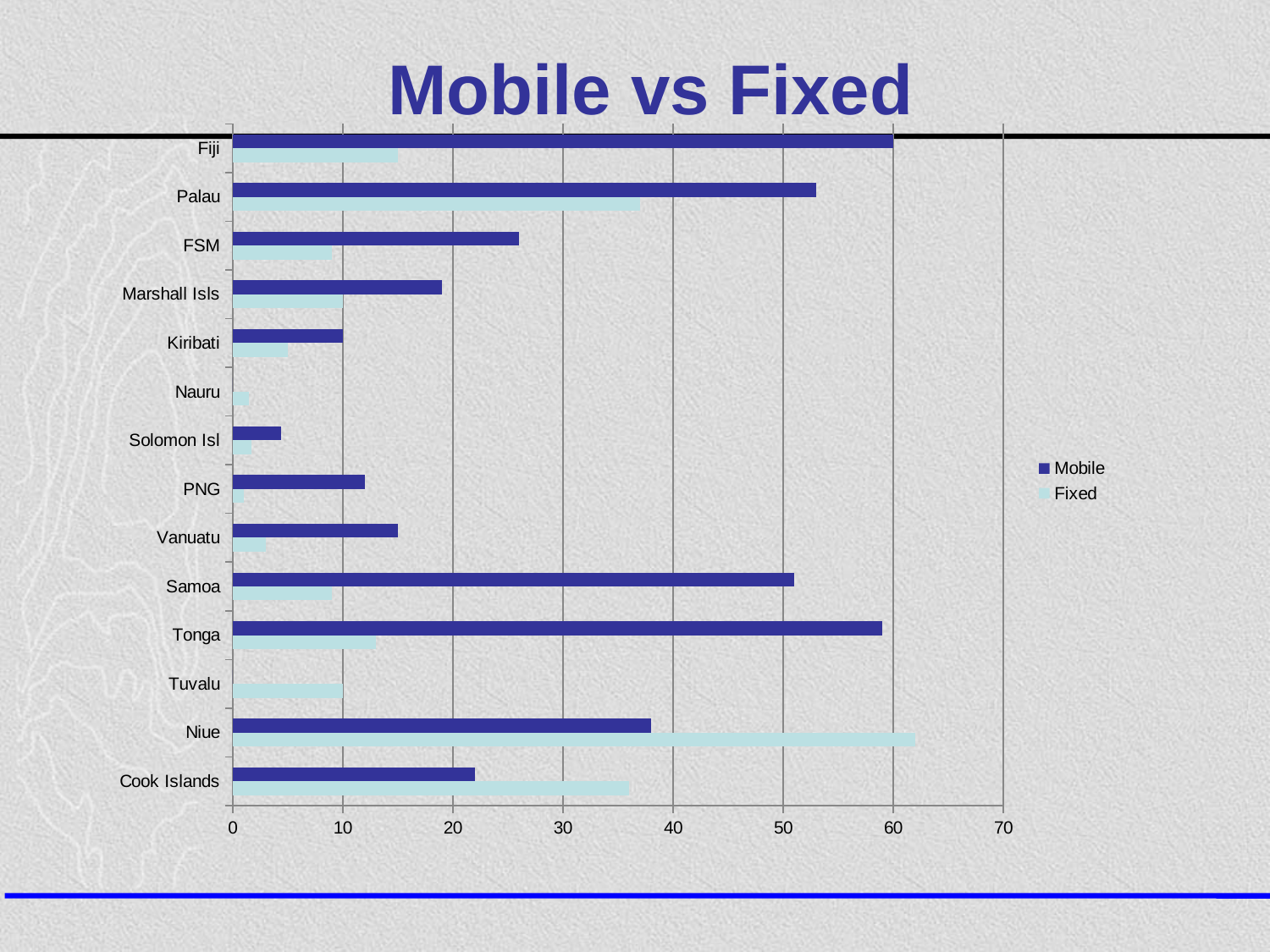
Is the Fixed value for Palau greater or less than 30? greater Which country has the highest Fixed value? Niue Is the Fixed value for PNG greater or less than 10? less How many countries are shown on the chart? 14 For Palau, which is larger, the Mobile value or the Fixed value? Mobile What kind of chart is shown on the slide? bar chart For Niue, which is larger, the Mobile value or the Fixed value? Fixed How many series does the legend list? 2 What is the title of the chart? Mobile vs Fixed Which series is shown in the lighter blue colour? Fixed Is the Mobile value for Vanuatu greater or less than 20? less